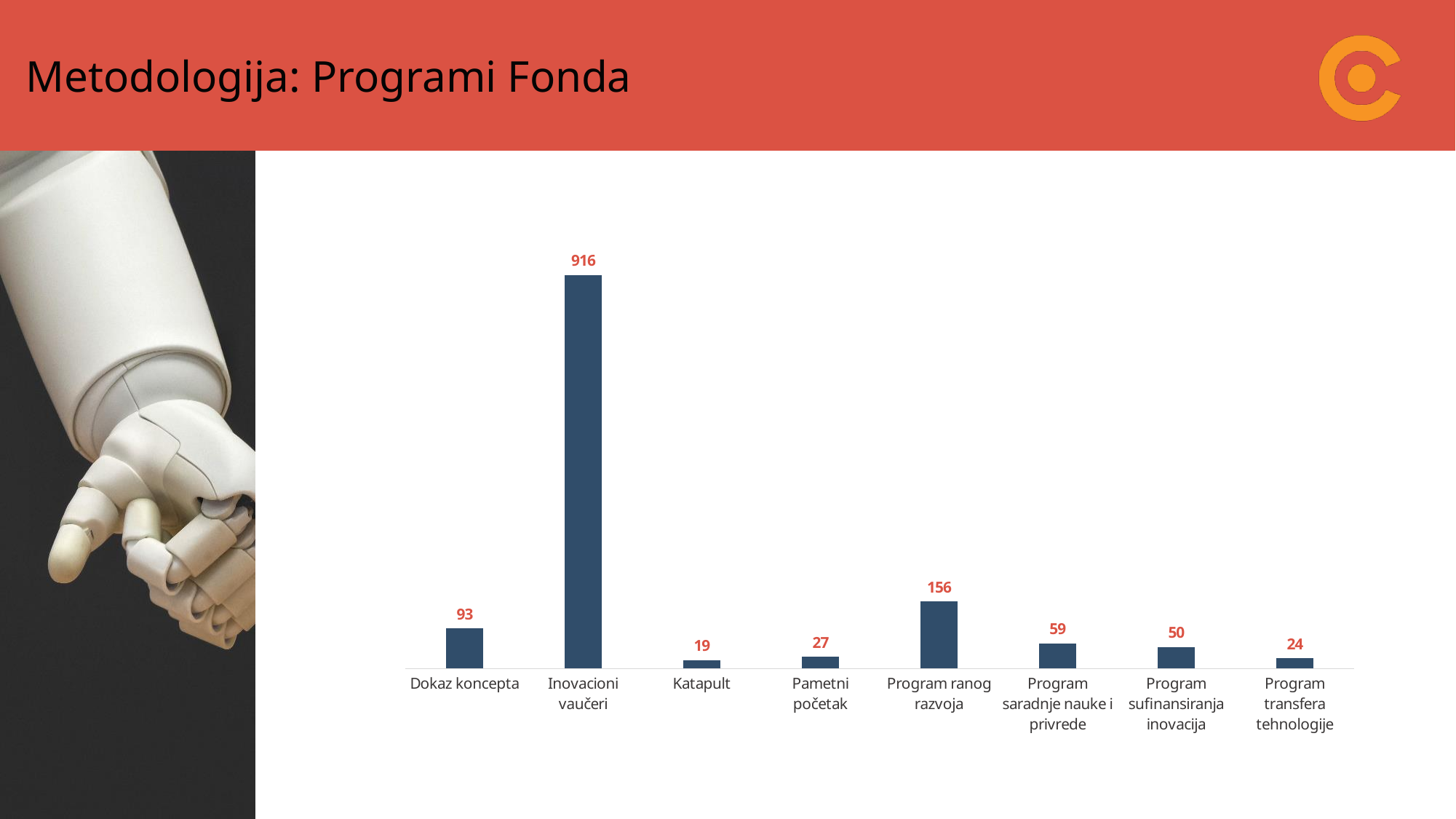
How many categories are shown on the chart? 8 What is the title of the slide containing the chart? Metodologija: Programi Fonda What is the difference between the values for Dokaz koncepta and Program saradnje nauke i privrede? 34 Which is larger, the value for Pametni početak or the value for Program transfera tehnologije? Pametni početak What is the difference between the values for Inovacioni vaučeri and Program ranog razvoja? 760 Which category has the lowest value? Katapult What is the value for Katapult? 19 Which category has the highest value? Inovacioni vaučeri What is the value for Program ranog razvoja? 156 What kind of chart is shown on the slide? Bar chart What is the value for Inovacioni vaučeri? 916 What is the value for Program sufinansiranja inovacija? 50